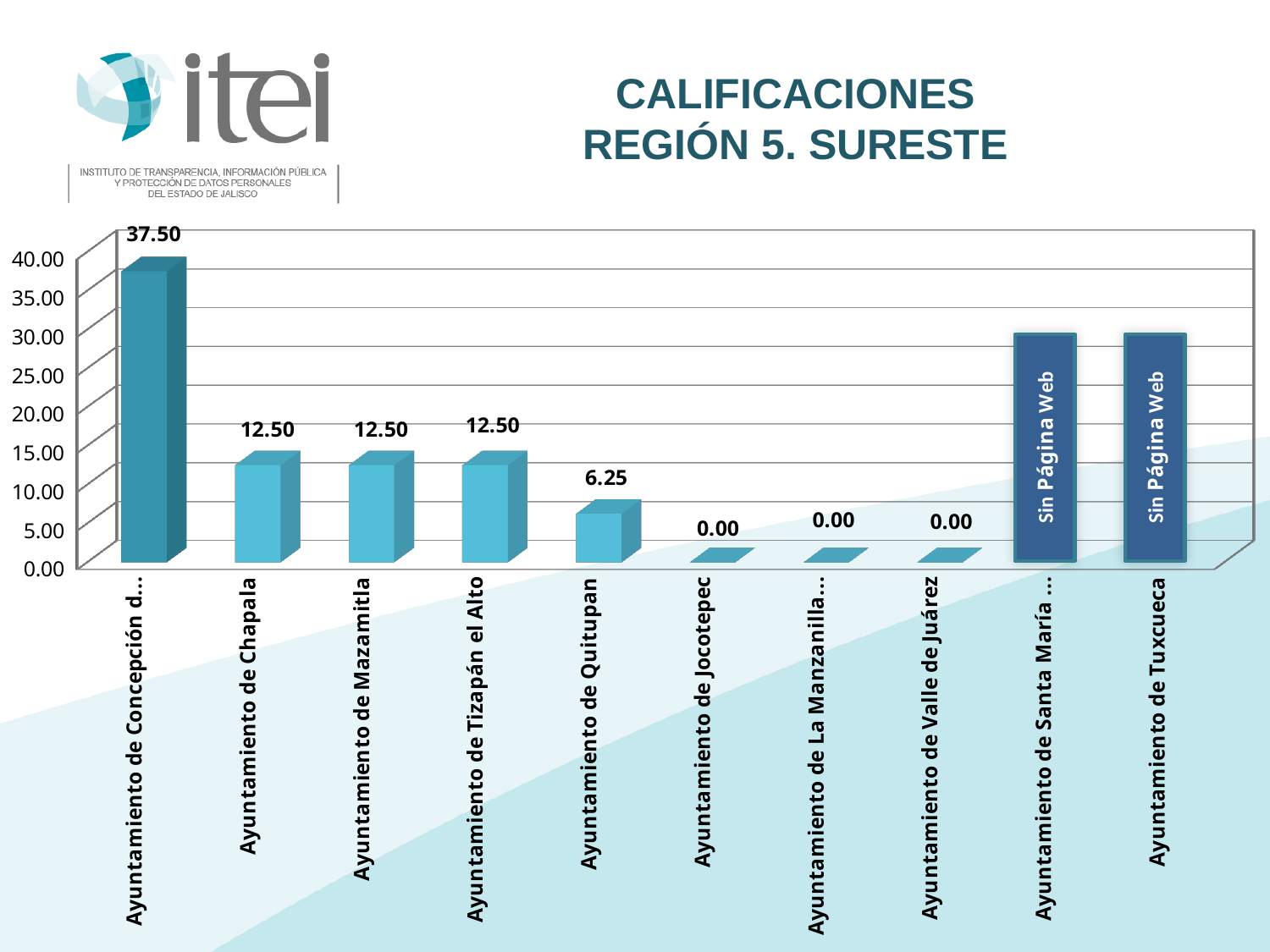
What is the value shown for the first (leftmost) bar in the chart? 37.50 Which is larger, the value for Ayuntamiento de Chapala or the value for Ayuntamiento de Quitupan? Ayuntamiento de Chapala What is the title of the slide containing the chart? CALIFICACIONES REGIÓN 5. SURESTE What is the value for Ayuntamiento de Chapala? 12.50 How many categories are shown on the x axis of the chart? 10 What is the value for Ayuntamiento de Tizapán el Alto? 12.50 What is the value for Ayuntamiento de Jocotepec? 0.00 What label is shown in place of a value for Ayuntamiento de Tuxcueca? Sin Página Web What kind of chart is shown on the slide? Bar chart What is the value for Ayuntamiento de Quitupan? 6.25 Is the value for the leftmost bar greater or less than 35.00? greater What is the difference between the value for Ayuntamiento de Mazamitla and the value for Ayuntamiento de Quitupan? 6.25